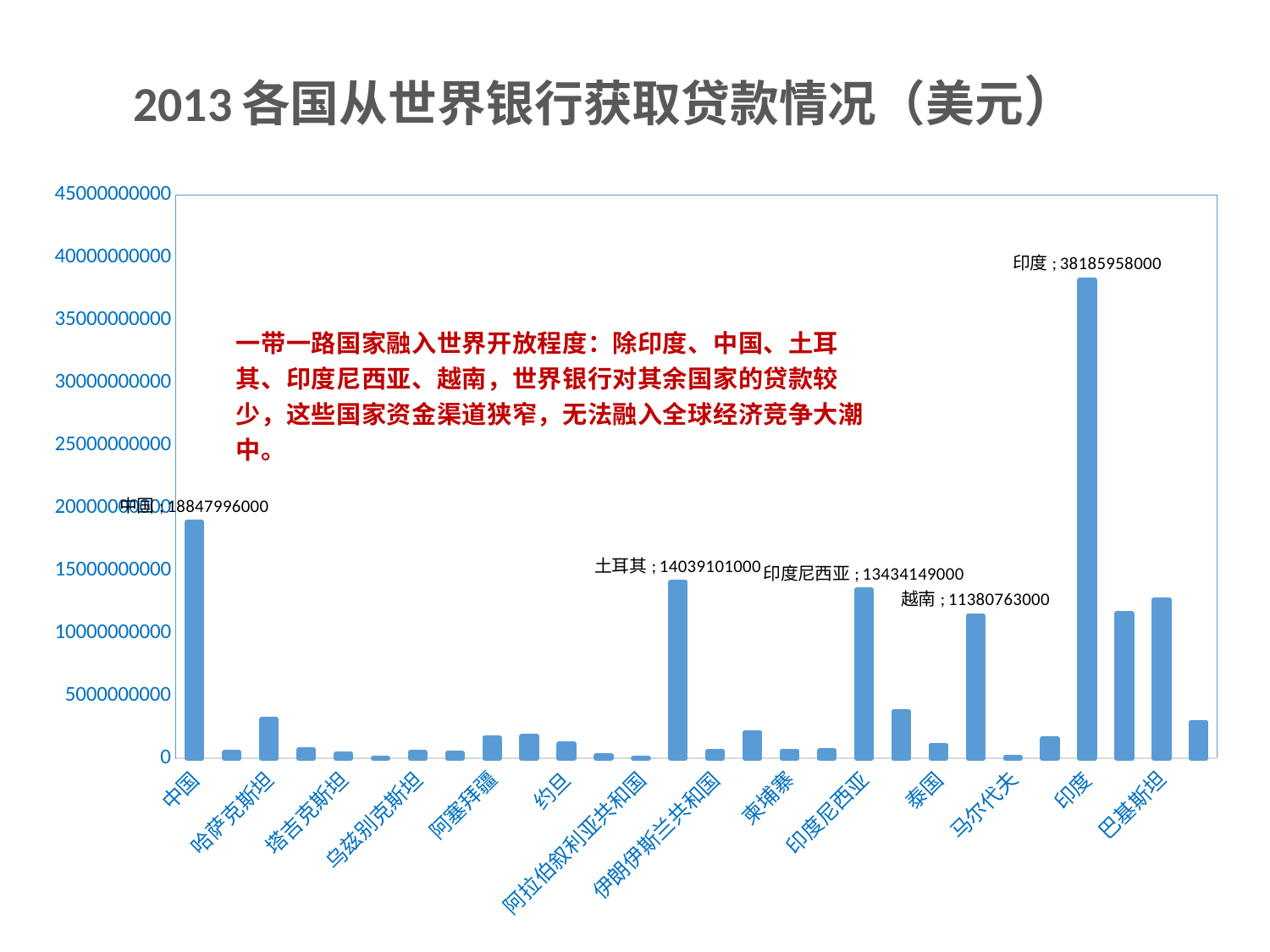
What is the title of the chart? 2013各国从世界银行获取贷款情况（美元） What is the difference between the values for 印度 and 中国? 19337962000 What is the difference between the values for 土耳其 and 印度尼西亚? 604952000 Is the value for 哈萨克斯坦 greater or less than 5000000000? less What is the value for 印度? 38185958000 Which country has the highest value? 印度 What kind of chart is shown on the slide? bar chart What is the value for 越南? 11380763000 Which is larger, the value for 中国 or the value for 越南? 中国 What is the value for 土耳其? 14039101000 What is the value for 印度尼西亚? 13434149000 What is the value for 中国? 18847996000